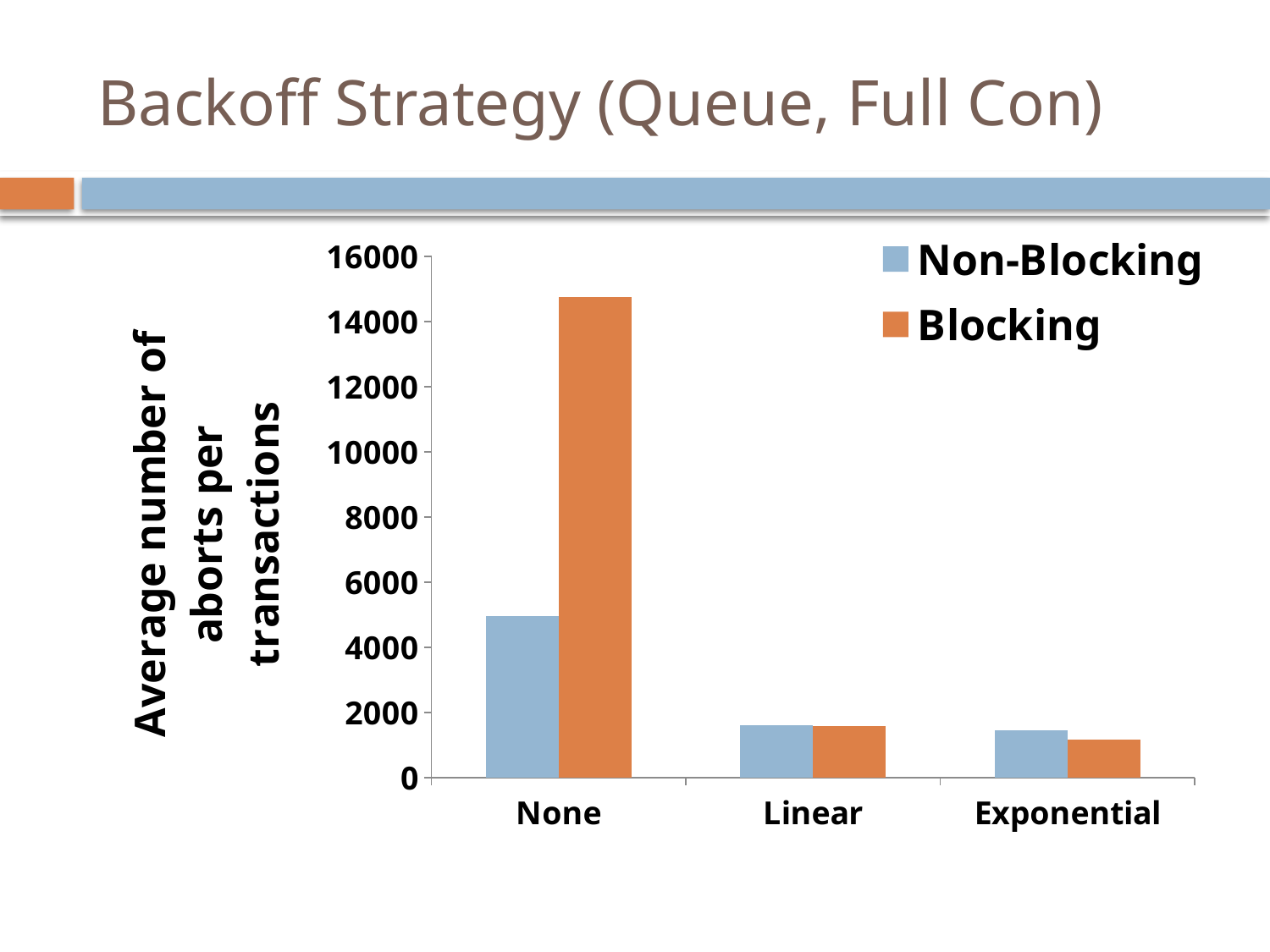
Which category has the lowest Blocking value? Exponential What is the title of the y axis? Average number of aborts per transactions Is the Blocking value for Linear greater or less than 2000? less How many backoff strategy categories are shown on the x axis? 3 Do the Blocking values rise or fall from None to Exponential along the x axis? fall Which category has the highest Blocking value? None For the None category, which series has the larger value, Non-Blocking or Blocking? Blocking Which category has the highest Non-Blocking value? None What kind of chart is shown on the slide? bar chart How many series does the legend list? 2 Is the Blocking value for None greater or less than 14000? greater Is the Non-Blocking value for None greater or less than 6000? less